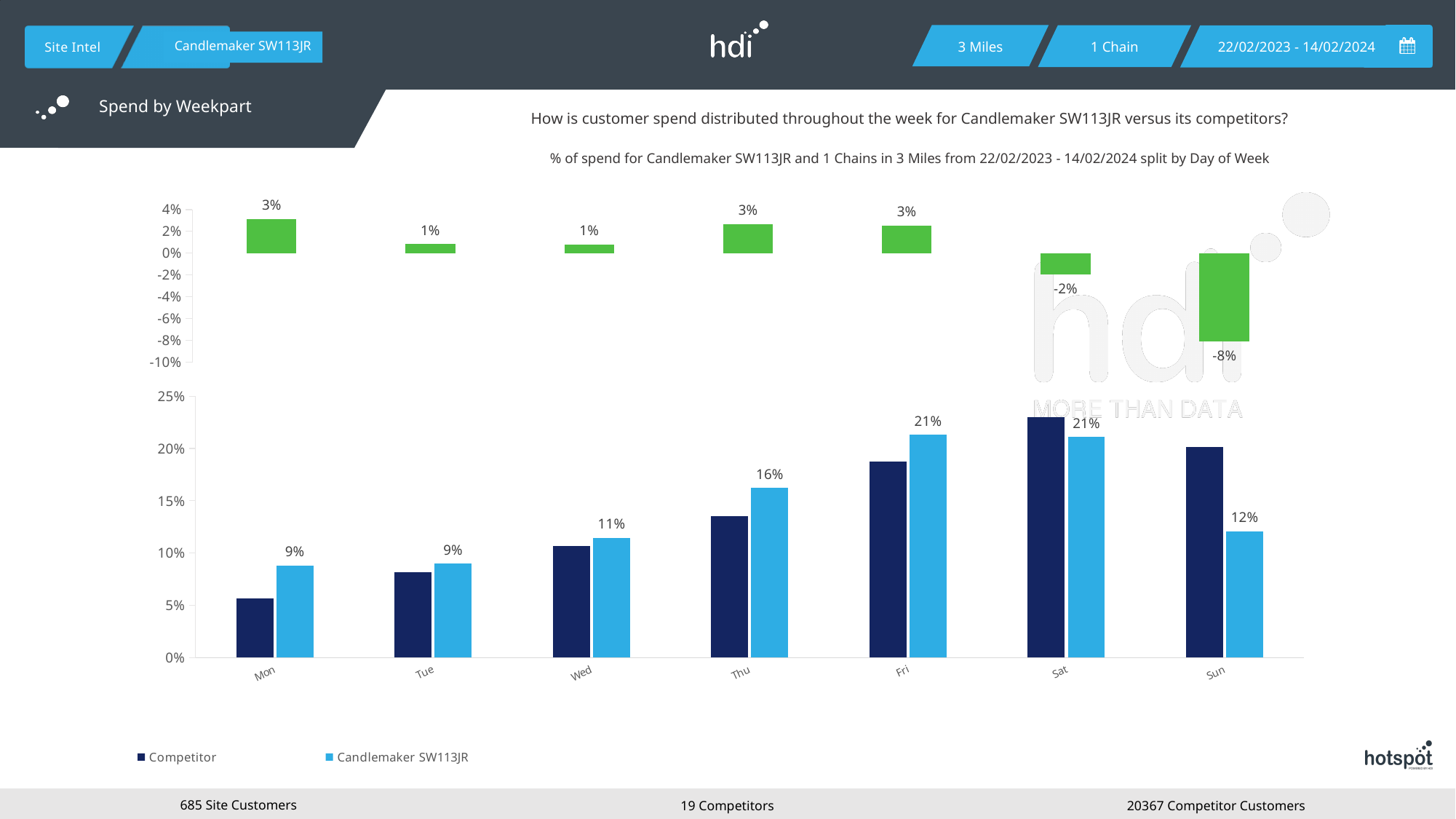
In the top chart, what is the value shown for Sun? -8% In the bottom chart, on Sun, which is larger: the Competitor bar or the Candlemaker SW113JR bar? Competitor How many days of the week are shown on the x axis of the bottom chart? 7 In the bottom chart, is the Competitor value for Mon greater or less than 10%? less In the bottom chart, on which day is the Competitor bar highest? Sat What type of chart is the bottom chart? bar chart In the bottom chart, what is the difference between the Candlemaker SW113JR values for Fri and Mon? 12% In the bottom chart, is the Competitor value for Sat greater or less than 20%? greater In the top chart, which day has the lowest value? Sun In the bottom chart, what is the value for Candlemaker SW113JR on Thu? 16% How many series does the legend of the bottom chart list? 2 In the bottom chart, do the Candlemaker SW113JR values rise or fall from Mon to Fri? rise